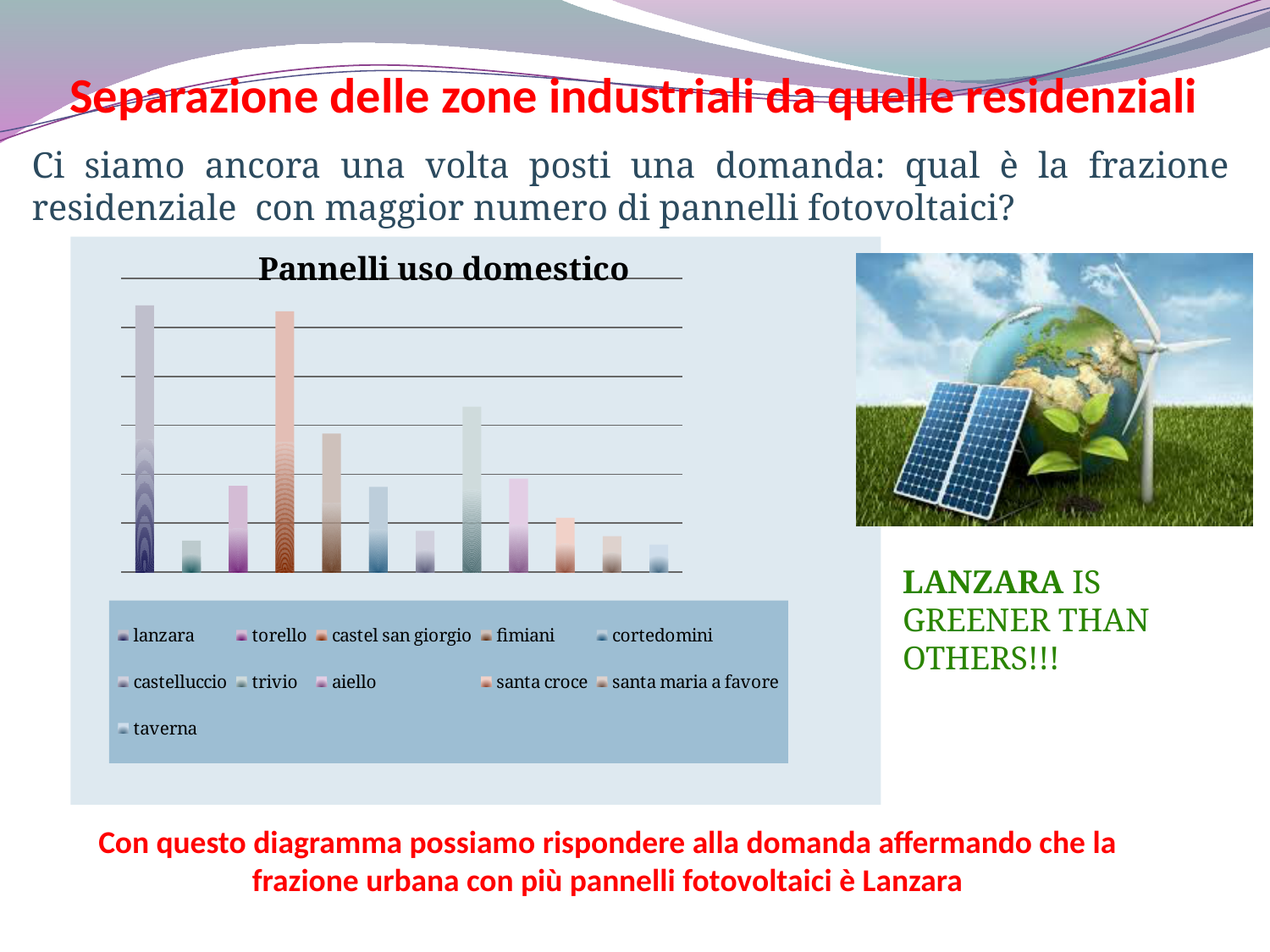
What is the title of the chart? Pannelli uso domestico Which has the larger value, lanzara or torello? lanzara Which legend entry is listed first in the chart legend? lanzara Which locality has the highest bar in the chart? lanzara Which has the larger value, cortedomini or castelluccio? cortedomini Which has the larger value, santa croce or aiello? aiello Which locality has the second highest bar in the chart? castel san giorgio How many bars are plotted in the chart? 12 What kind of chart is shown on the slide? bar chart How many entries does the chart legend list? 11